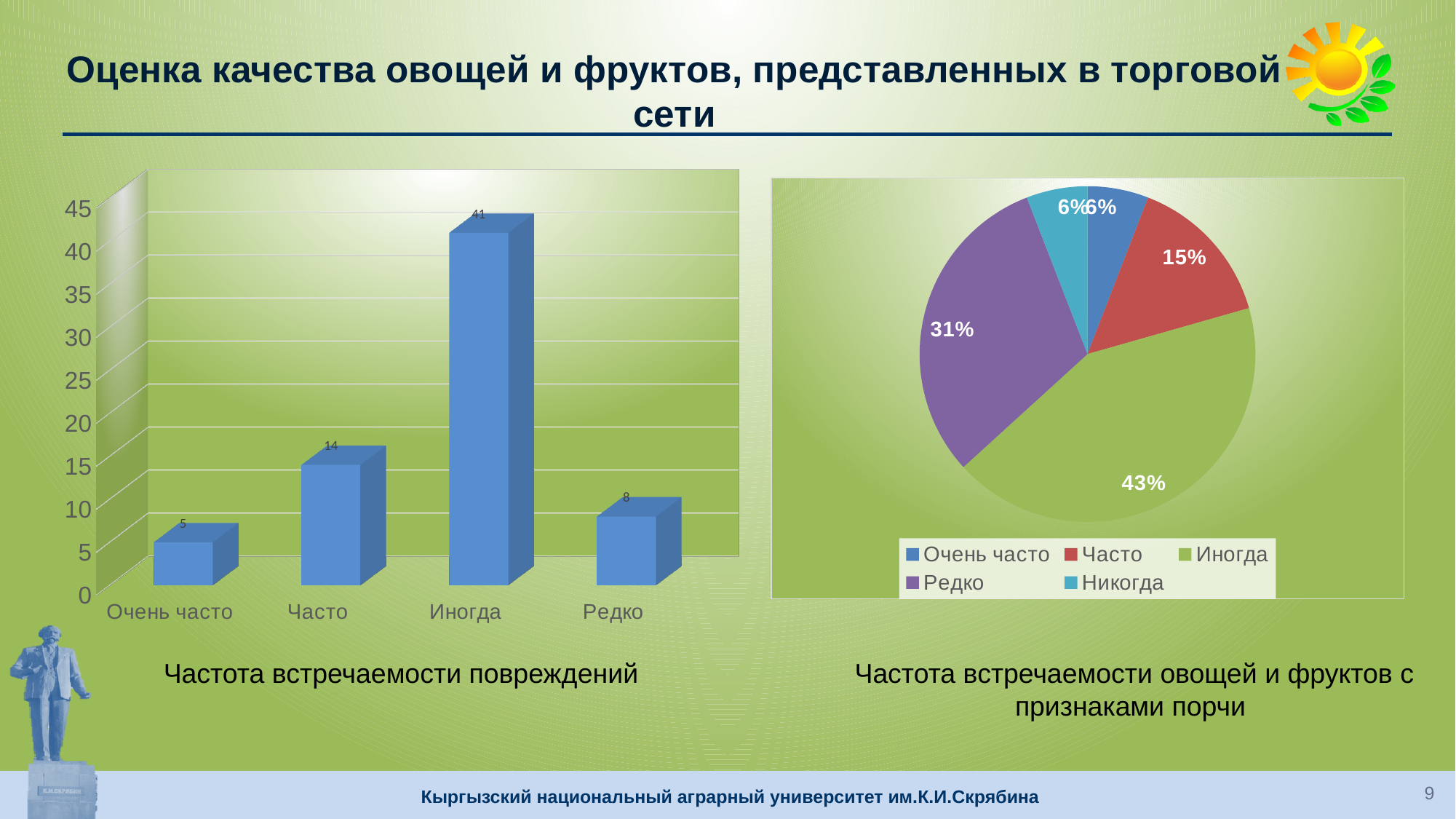
In the bar chart 'Частота встречаемости повреждений', what is the value for Очень часто? 5 What kind of chart is the left chart, 'Частота встречаемости повреждений'? Bar chart In the pie chart 'Частота встречаемости овощей и фруктов с признаками порчи', what share does Иногда have? 43% In the bar chart 'Частота встречаемости повреждений', which category has the highest value? Иногда In the bar chart 'Частота встречаемости повреждений', which category has the lowest value? Очень часто In the bar chart 'Частота встречаемости повреждений', how many categories are shown on the x axis? 4 In the bar chart 'Частота встречаемости повреждений', what is the difference between the values for Часто and Редко? 6 In the pie chart 'Частота встречаемости овощей и фруктов с признаками порчи', how many entries does the legend list? 5 In the bar chart 'Частота встречаемости повреждений', what is the value for Иногда? 41 In the pie chart 'Частота встречаемости овощей и фруктов с признаками порчи', which slice is the largest? Иногда In the pie chart 'Частота встречаемости овощей и фруктов с признаками порчи', which is larger, the share for Часто or the share for Редко? Редко In the pie chart 'Частота встречаемости овощей и фруктов с признаками порчи', what share does Редко have? 31%